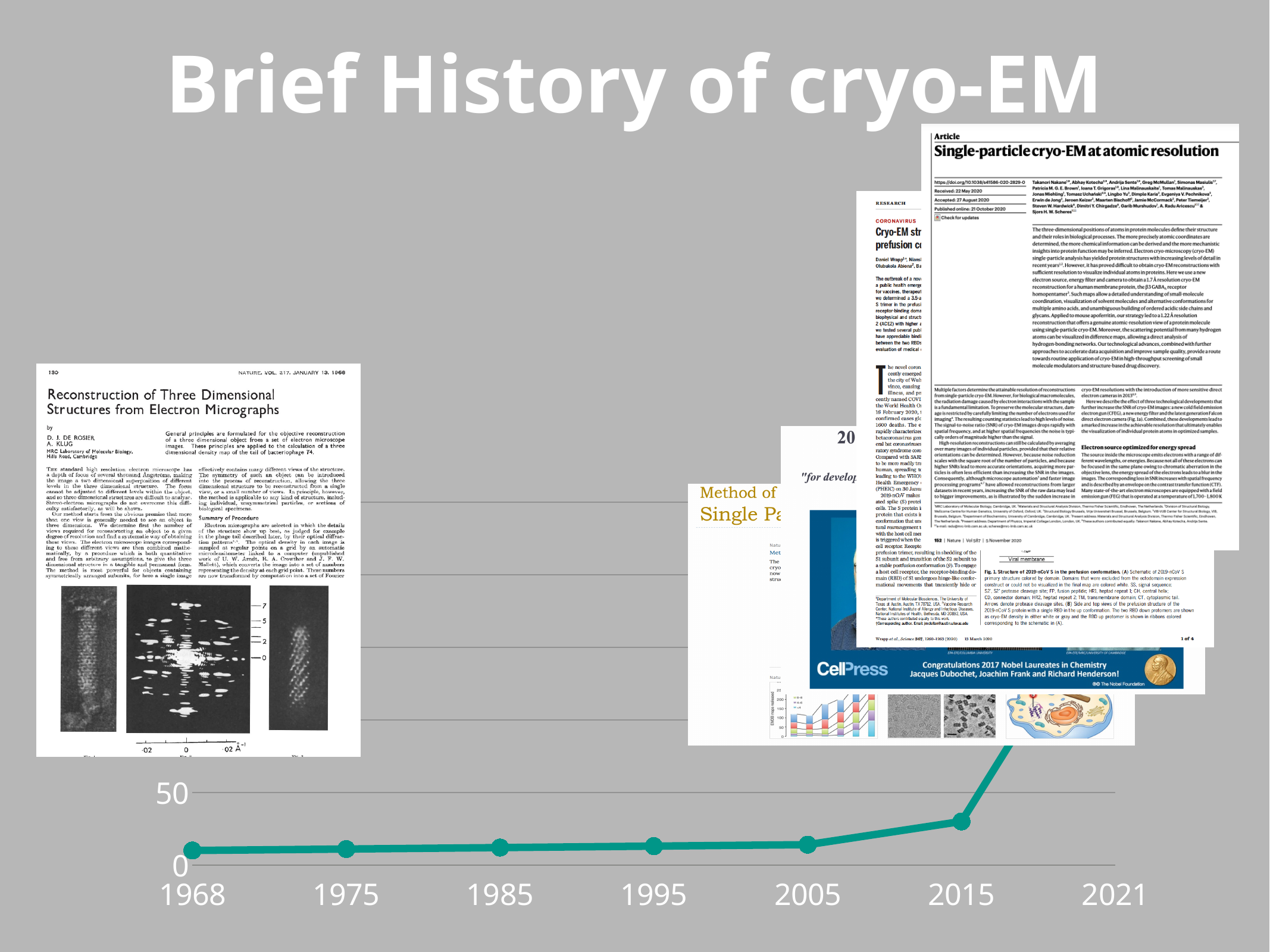
Is the value for 2005 greater or less than 50? less How many years are labelled along the x axis of the chart? 7 Which year has the larger value, 2005 or 2015? 2015 What is the first year labelled on the x axis of the chart? 1968 Which year has the larger value, 1968 or 2015? 2015 What colour is the line plotted in the chart? green What is the title of the slide containing the chart? Brief History of cryo-EM Do the values in the chart rise or fall from 1968 to 2021? rise Is the value for 1968 greater or less than 50? less What is the last year labelled on the x axis of the chart? 2021 What kind of chart is shown on the slide? line chart Is the value for 2015 greater or less than 50? less